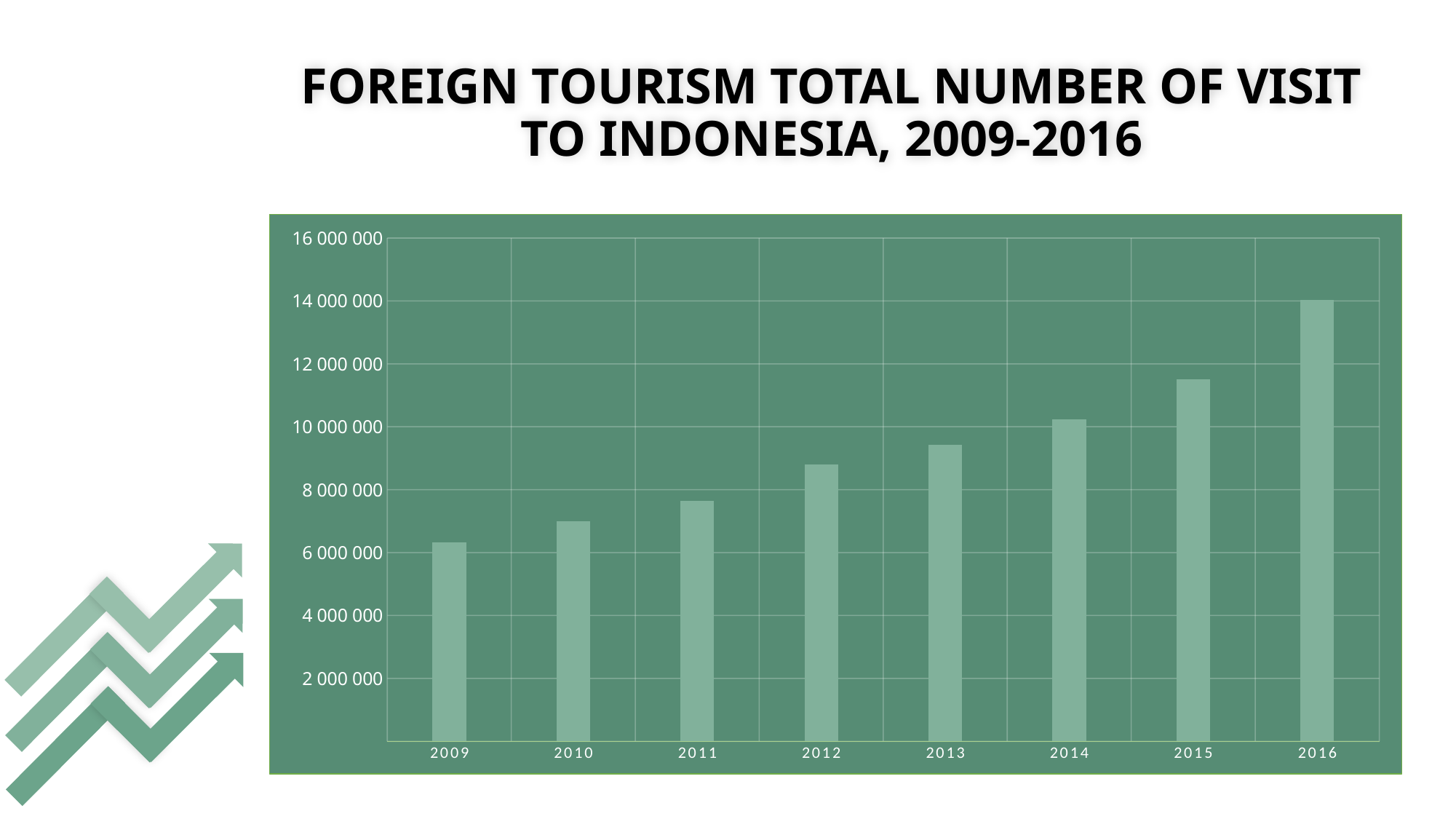
Which year has the highest number of foreign tourist visits? 2016 What type of chart is shown on the slide? Bar chart Do the values rise or fall from 2009 to 2016? Rise Is the value for 2016 greater or less than 12 000 000? greater How many years are shown on the x axis of the chart? 8 What is the title of the chart? FOREIGN TOURISM TOTAL NUMBER OF VISIT TO INDONESIA, 2009-2016 Which year has the larger value, 2011 or 2014? 2014 Is the value for 2013 greater or less than 10 000 000? less Is the value for 2012 greater or less than 8 000 000? greater Which year has the lowest number of foreign tourist visits? 2009